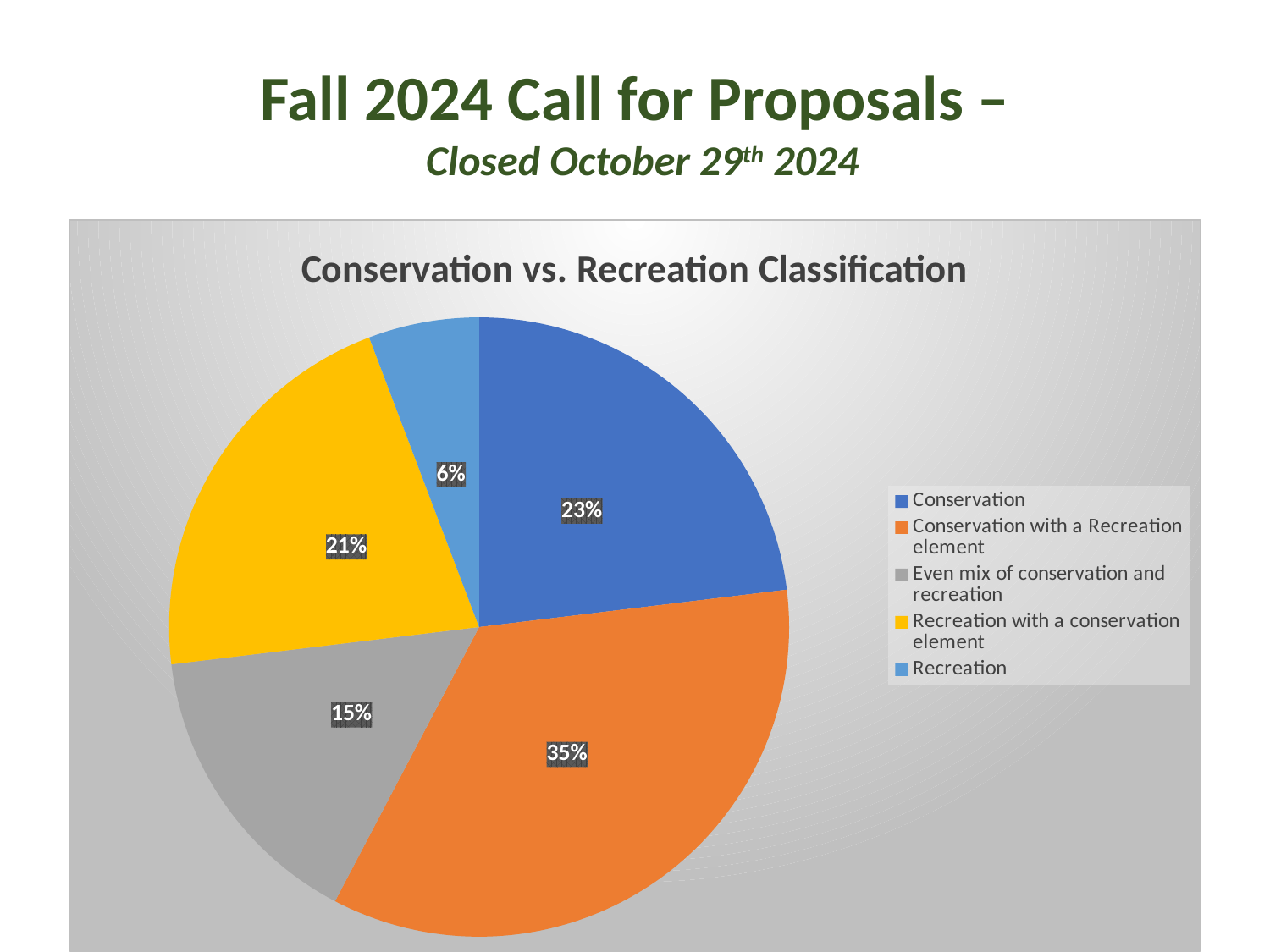
Which category has the largest slice of the pie? Conservation with a Recreation element What share of the pie is Recreation with a conservation element? 21% What is the difference in percentage points between Conservation with a Recreation element and Conservation? 12 percentage points Which category has the smallest slice of the pie? Recreation Which is larger: the share for Recreation with a conservation element or the share for Even mix of conservation and recreation? Recreation with a conservation element What share of the pie is Conservation with a Recreation element? 35% What kind of chart is shown on the slide? Pie chart What share of the pie is Conservation? 23% How many categories does the pie chart show? 5 What is the title of the chart? Conservation vs. Recreation Classification